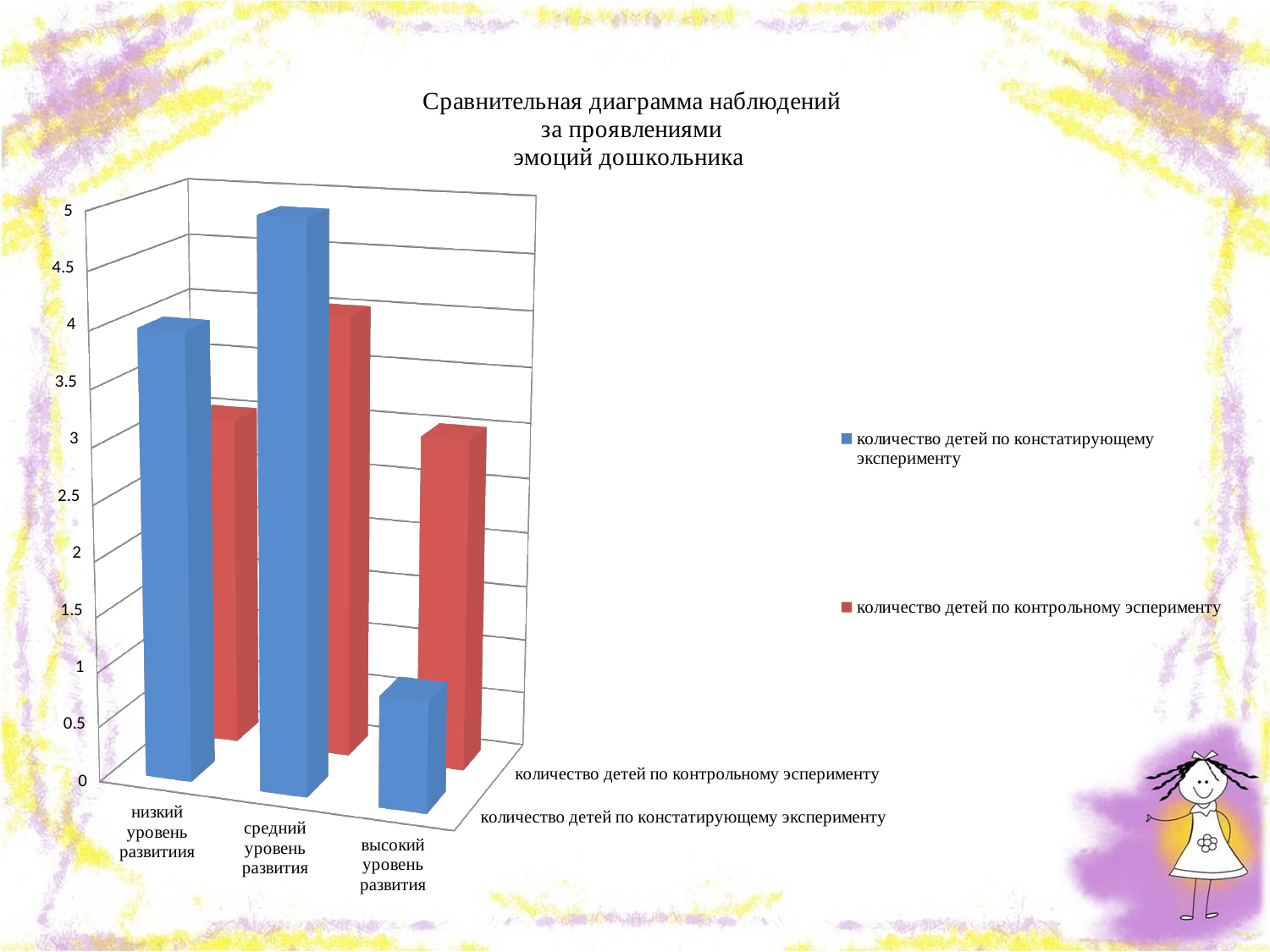
Which category has the highest value for the series 'количество детей по контрольному эсперименту'? средний уровень развития Which colour represents the series 'количество детей по контрольному эсперименту' in the chart? red Is the value for 'средний уровень развития' in the series 'количество детей по констатирующему эксперименту' greater or less than 4? greater How many categories are shown on the x axis of the chart? 3 What kind of chart is shown on the slide? bar chart Is the value for 'высокий уровень развития' in the series 'количество детей по констатирующему эксперименту' greater or less than 2? less For 'высокий уровень развития', which series has the larger value: 'количество детей по констатирующему эксперименту' or 'количество детей по контрольному эсперименту'? количество детей по контрольному эсперименту Which category has the highest value for the series 'количество детей по констатирующему эксперименту'? средний уровень развития What is the title of the chart? Сравнительная диаграмма наблюдений за проявлениями эмоций дошкольника How many series does the chart's legend list? 2 For 'низкий уровень развитиия', which series has the larger value: 'количество детей по констатирующему эксперименту' or 'количество детей по контрольному эсперименту'? количество детей по констатирующему эксперименту Which category has the lowest value for the series 'количество детей по констатирующему эксперименту'? высокий уровень развития